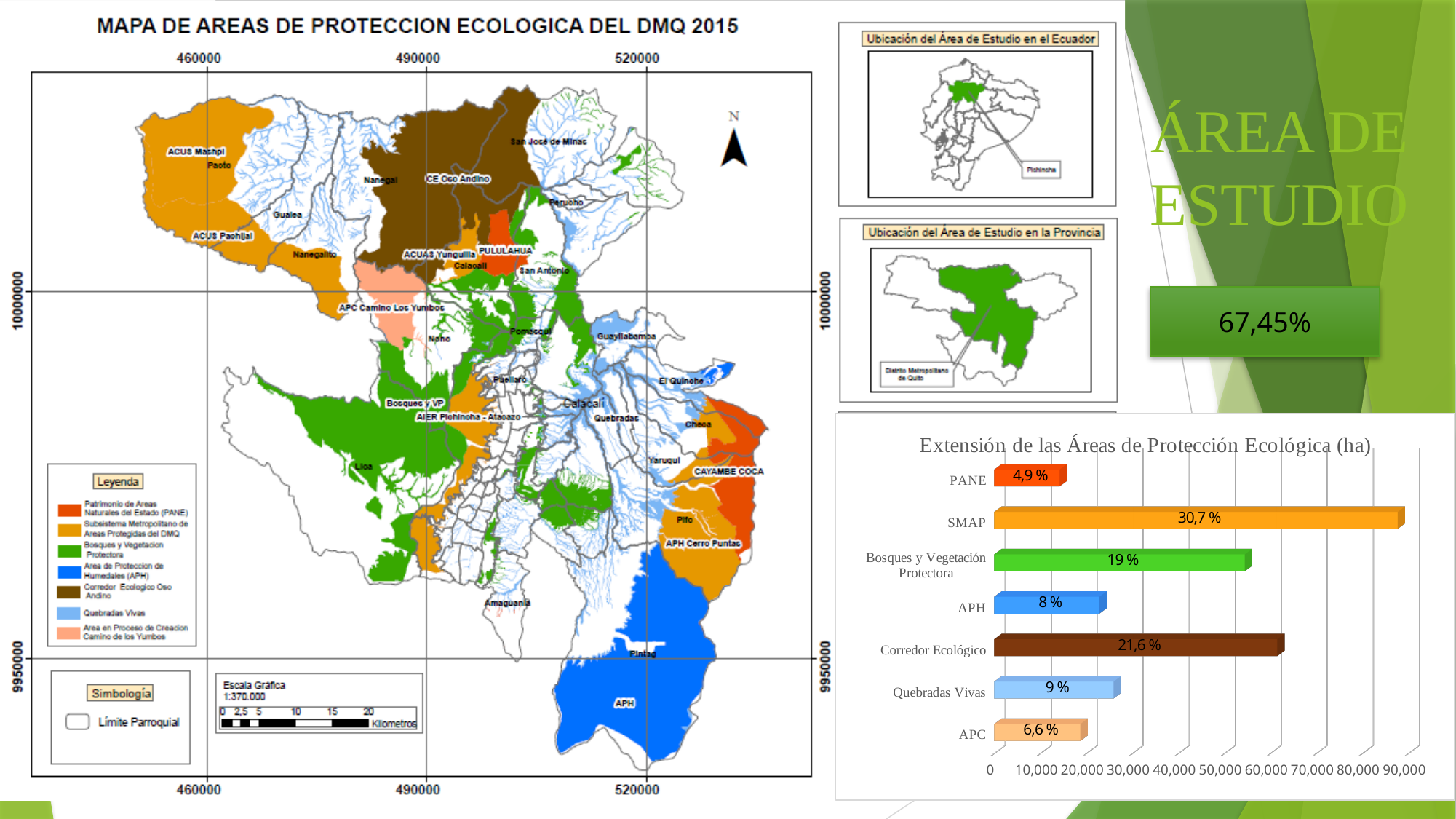
What type of chart is 'Extensión de las Áreas de Protección Ecológica (ha)'? bar chart Which category has the largest extension in the 'Extensión de las Áreas de Protección Ecológica (ha)' chart? SMAP What percentage label is shown for SMAP in the 'Extensión de las Áreas de Protección Ecológica (ha)' chart? 30,7 % How many categories are shown in the 'Extensión de las Áreas de Protección Ecológica (ha)' chart? 7 In the 'Extensión de las Áreas de Protección Ecológica (ha)' chart, is the value for Bosques y Vegetación Protectora greater or less than 50,000? greater What percentage label is shown for Corredor Ecológico in the 'Extensión de las Áreas de Protección Ecológica (ha)' chart? 21,6 % What percentage label is shown for Bosques y Vegetación Protectora in the 'Extensión de las Áreas de Protección Ecológica (ha)' chart? 19 % Which category has the smallest extension in the 'Extensión de las Áreas de Protección Ecológica (ha)' chart? PANE In the 'Extensión de las Áreas de Protección Ecológica (ha)' chart, which is larger, APH or Quebradas Vivas? Quebradas Vivas What percentage label is shown for APC in the 'Extensión de las Áreas de Protección Ecológica (ha)' chart? 6,6 % In the 'Extensión de las Áreas de Protección Ecológica (ha)' chart, is the value for SMAP greater or less than 80,000? greater What is the difference between the percentage labels of SMAP and PANE in the 'Extensión de las Áreas de Protección Ecológica (ha)' chart? 25,8 %